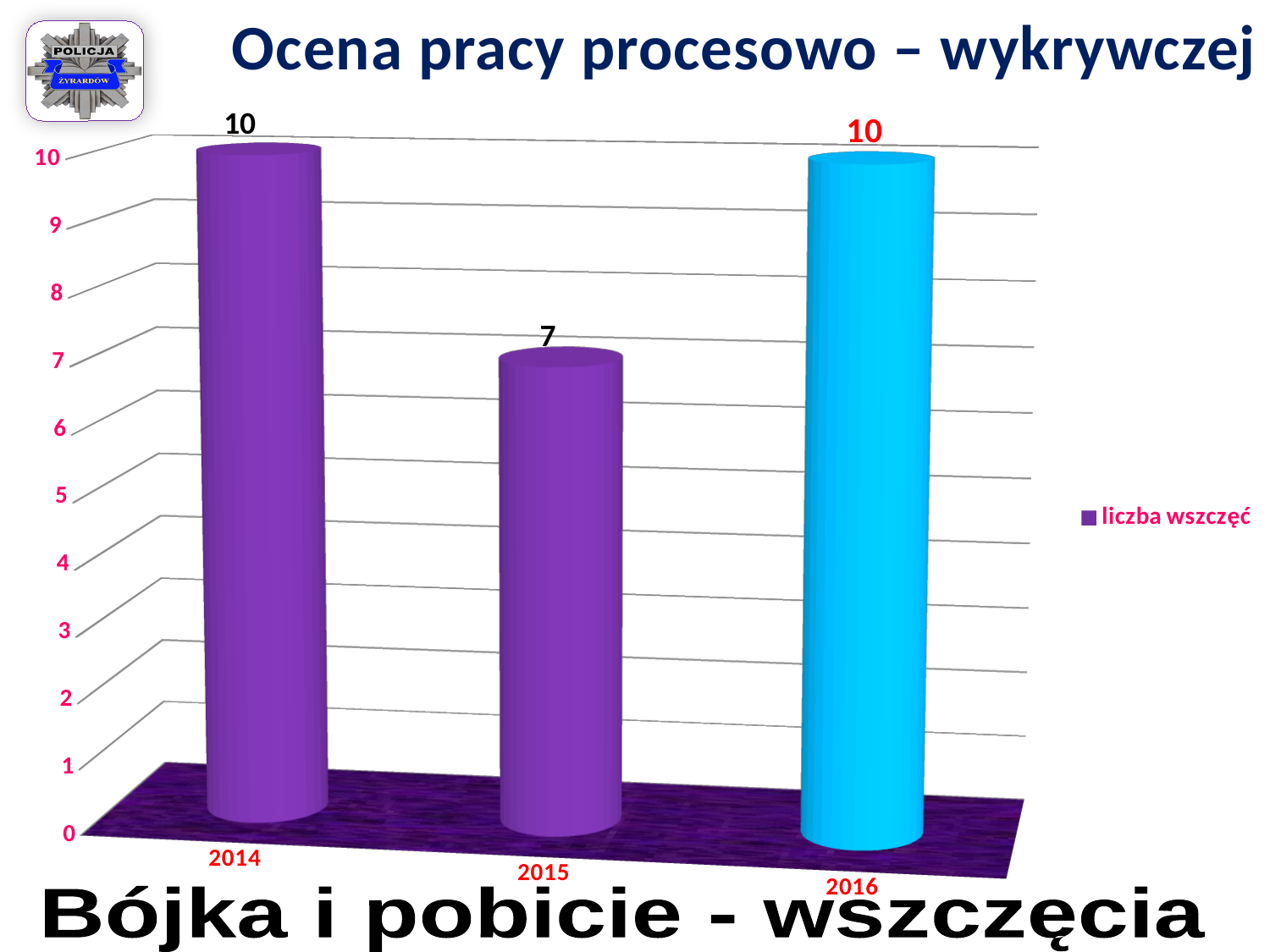
How many series does the legend list? 1 What is the series name shown in the legend? liczba wszczęć Which year has the lowest value? 2015 What is the value for 2015? 7 How many years are shown on the chart? 3 What kind of chart is shown? bar chart Which is larger, the value for 2015 or the value for 2016? 2016 What is the value for 2014? 10 What is the value for 2016? 10 What is the caption below the chart? Bójka i pobicie - wszczęcia What is the difference between the values for 2014 and 2015? 3 Is the value for 2015 greater or less than 5? greater